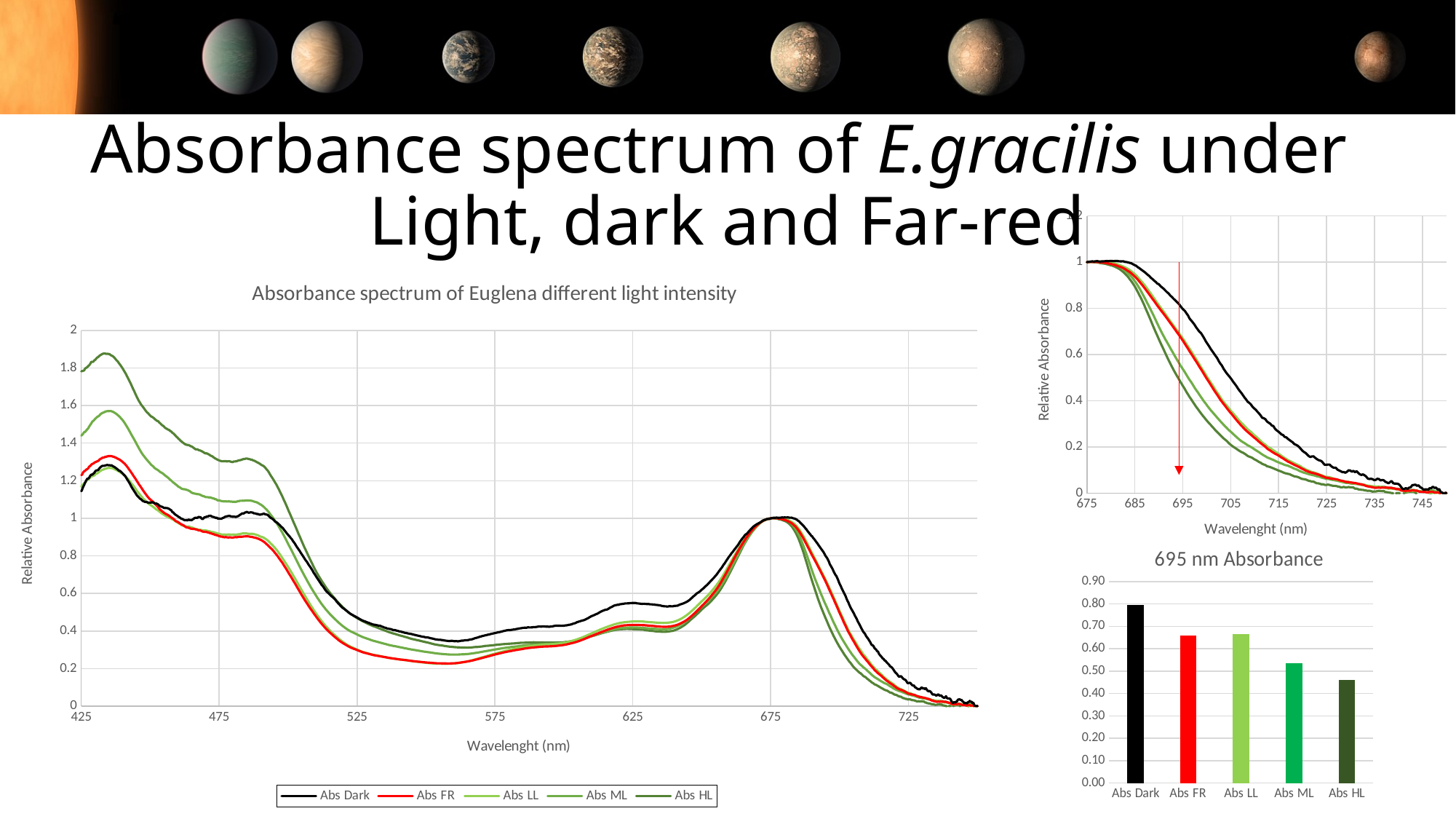
In the small line chart at the top right, do the values rise or fall as wavelength increases from 675 to 745 nm? fall How many series does the legend of 'Absorbance spectrum of Euglena different light intensity' list? 5 In the '695 nm Absorbance' chart, which category has the lowest bar? Abs HL In the '695 nm Absorbance' chart, is the value for Abs ML greater or less than 0.60? less In the '695 nm Absorbance' chart, is the value for Abs HL greater or less than 0.50? less How many categories are shown in the '695 nm Absorbance' bar chart? 5 In 'Absorbance spectrum of Euglena different light intensity', which series is drawn in red? Abs FR In the '695 nm Absorbance' chart, is the value for Abs Dark greater or less than 0.70? greater What kind of chart is the '695 nm Absorbance' chart? bar chart In the '695 nm Absorbance' chart, which category has the highest bar? Abs Dark In the '695 nm Absorbance' chart, which is larger, the bar for Abs Dark or the bar for Abs HL? Abs Dark What kind of chart is 'Absorbance spectrum of Euglena different light intensity'? line chart